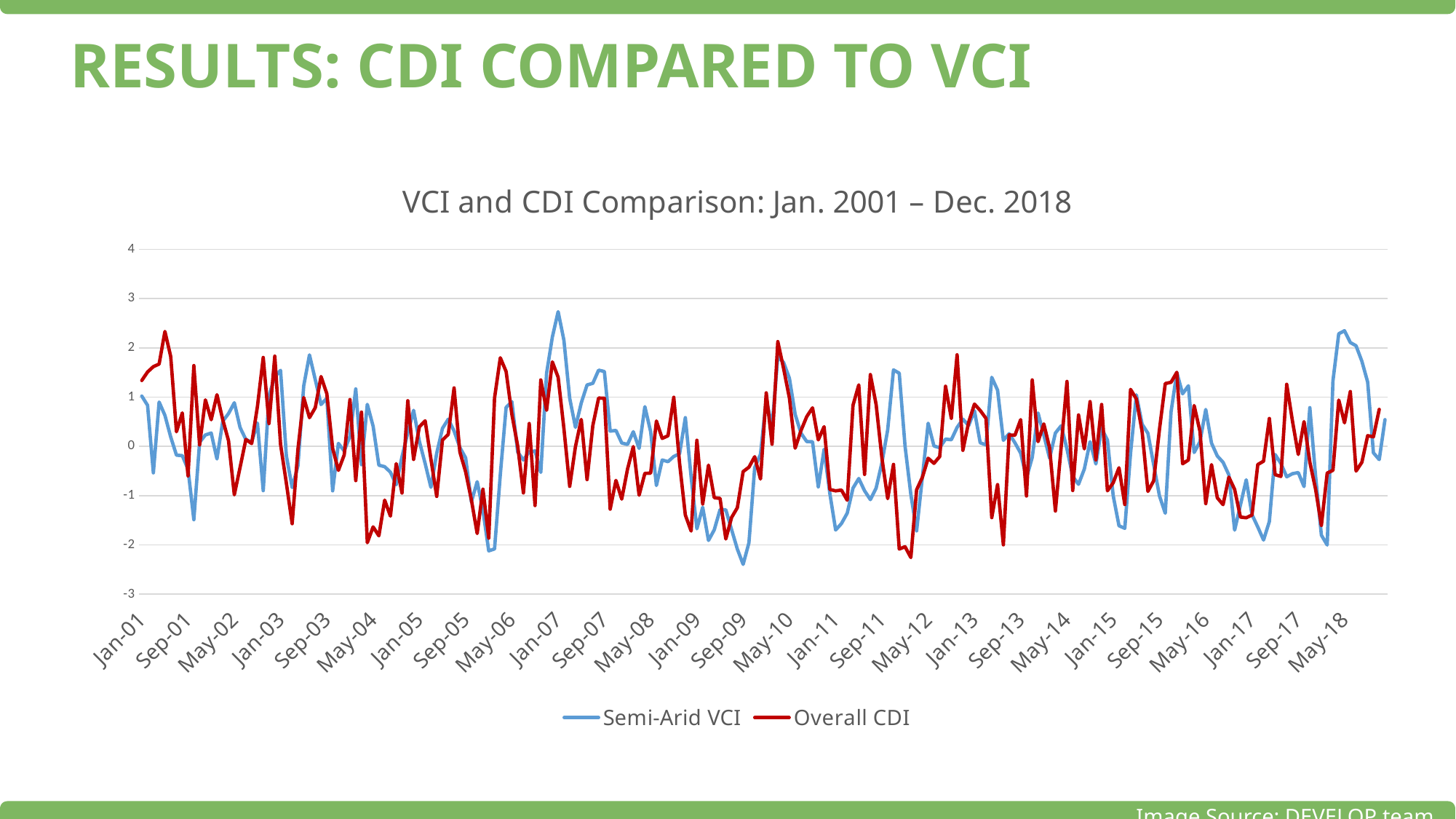
What is the lowest value shown on the vertical axis? -3 What kind of chart is shown on the slide? line chart Is the lowest value of the Overall CDI series near May-12 greater or less than -2? less How many series does the legend list? 2 Is the lowest value of the Semi-Arid VCI series near Sep-09 greater or less than -2? less What is the title of the chart? VCI and CDI Comparison: Jan. 2001 – Dec. 2018 Which colour is used for the Semi-Arid VCI series? blue How many date labels are shown along the horizontal axis? 27 What is the highest value shown on the vertical axis? 4 Is the peak value of the Overall CDI series near Sep-01 greater or less than 2? greater Which series reaches the higher maximum value over the whole period, Semi-Arid VCI or Overall CDI? Semi-Arid VCI